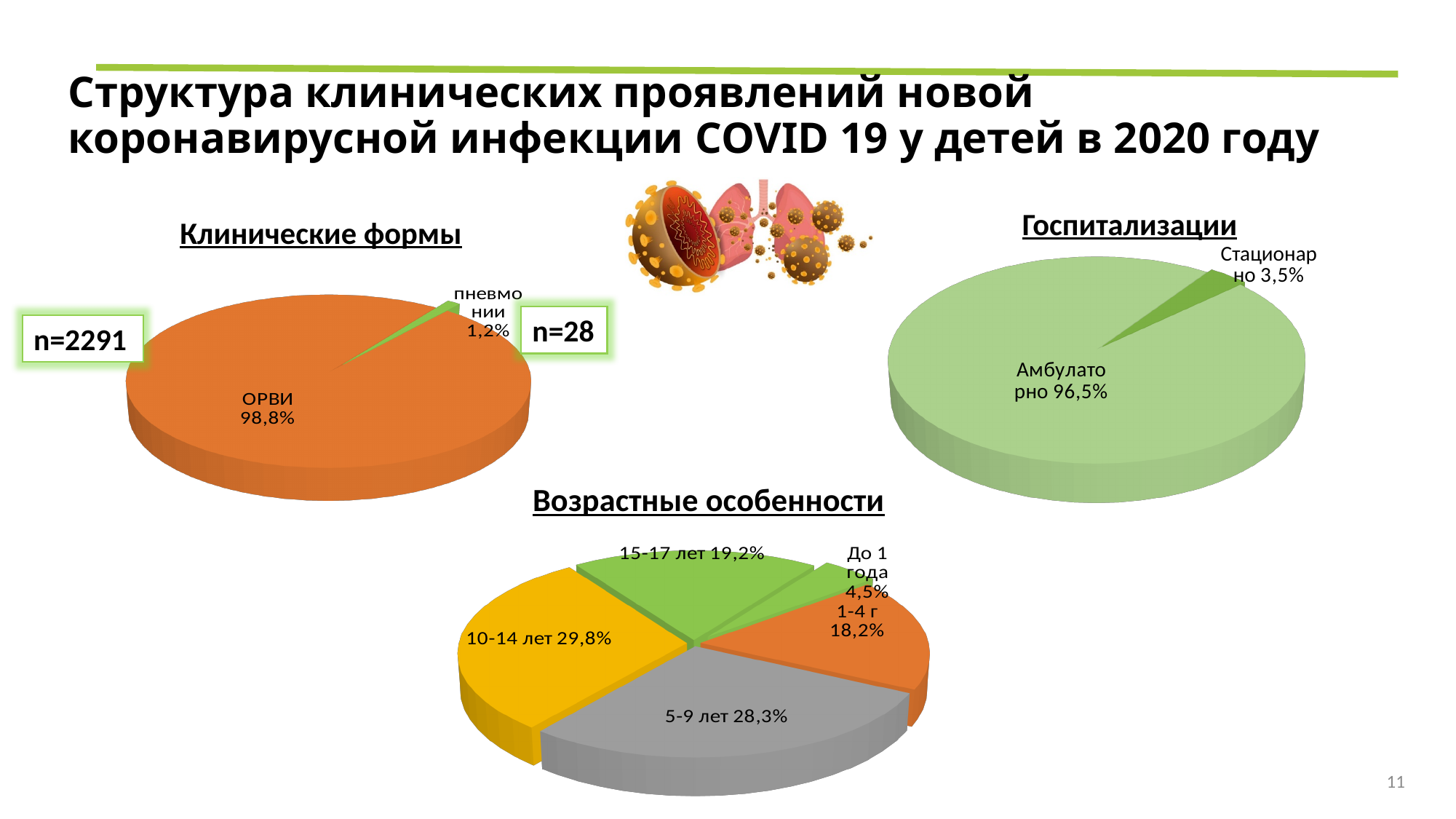
In the "Возрастные особенности" chart, what share is labelled for 5-9 лет? 28,3% In the "Возрастные особенности" chart, which is larger: the share for 1-4 г or the share for 15-17 лет? 15-17 лет How many pie charts are on the slide? 3 In the "Возрастные особенности" chart, which age group has the smallest share? До 1 года In the "Возрастные особенности" chart, which age group has the largest share? 10-14 лет What kind of chart is the "Госпитализации" chart? Pie chart In the "Госпитализации" chart, what is the difference between the Амбулаторно and Стационарно shares? 93% In the "Клинические формы" chart, what share is labelled for ОРВИ? 98,8% In the "Возрастные особенности" chart, what is the difference between the shares for 10-14 лет and 5-9 лет? 1,5% In the "Клинические формы" chart, what share is labelled for пневмонии? 1,2% In the "Возрастные особенности" chart, how many age groups are shown? 5 In the "Госпитализации" chart, what share is labelled for Стационарно? 3,5%